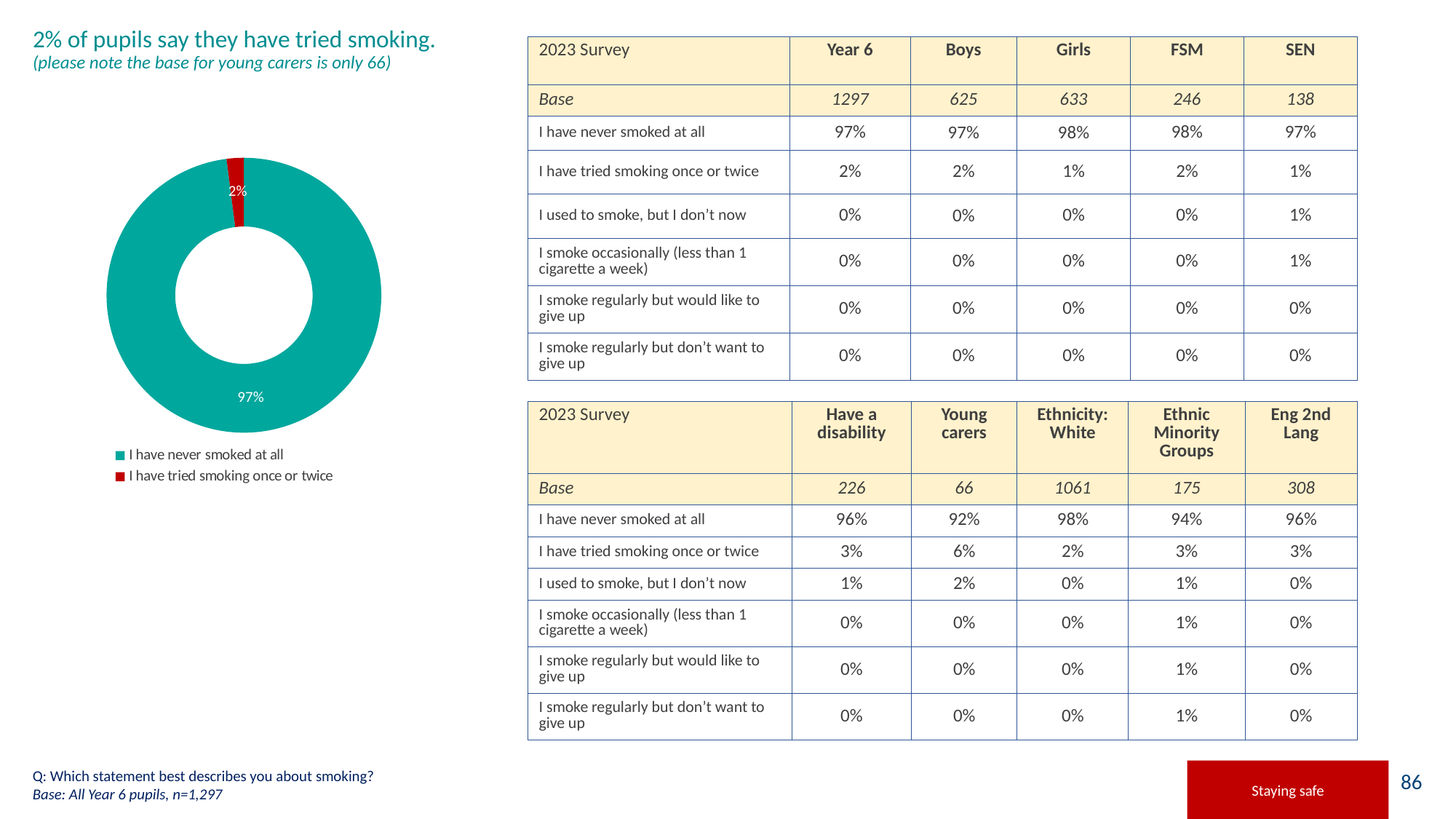
How many slices does the pie chart have? 2 What percentage of pupils say they have tried smoking once or twice, according to the pie chart? 2% What is the difference in percentage points between the 'I have never smoked at all' slice and the 'I have tried smoking once or twice' slice? 95 percentage points What share of the pie does the 'I have tried smoking once or twice' slice represent? 2% What colour is the 'I have tried smoking once or twice' slice in the pie chart? Red What type of chart is shown on the slide? Pie chart (donut) How many entries does the pie chart's legend list? 2 What percentage of pupils say they have never smoked at all, according to the pie chart? 97% Which is larger in the pie chart: 'I have never smoked at all' or 'I have tried smoking once or twice'? I have never smoked at all What colour is the 'I have never smoked at all' slice in the pie chart? Teal Which category has the largest slice in the pie chart? I have never smoked at all Which category has the smallest slice in the pie chart? I have tried smoking once or twice